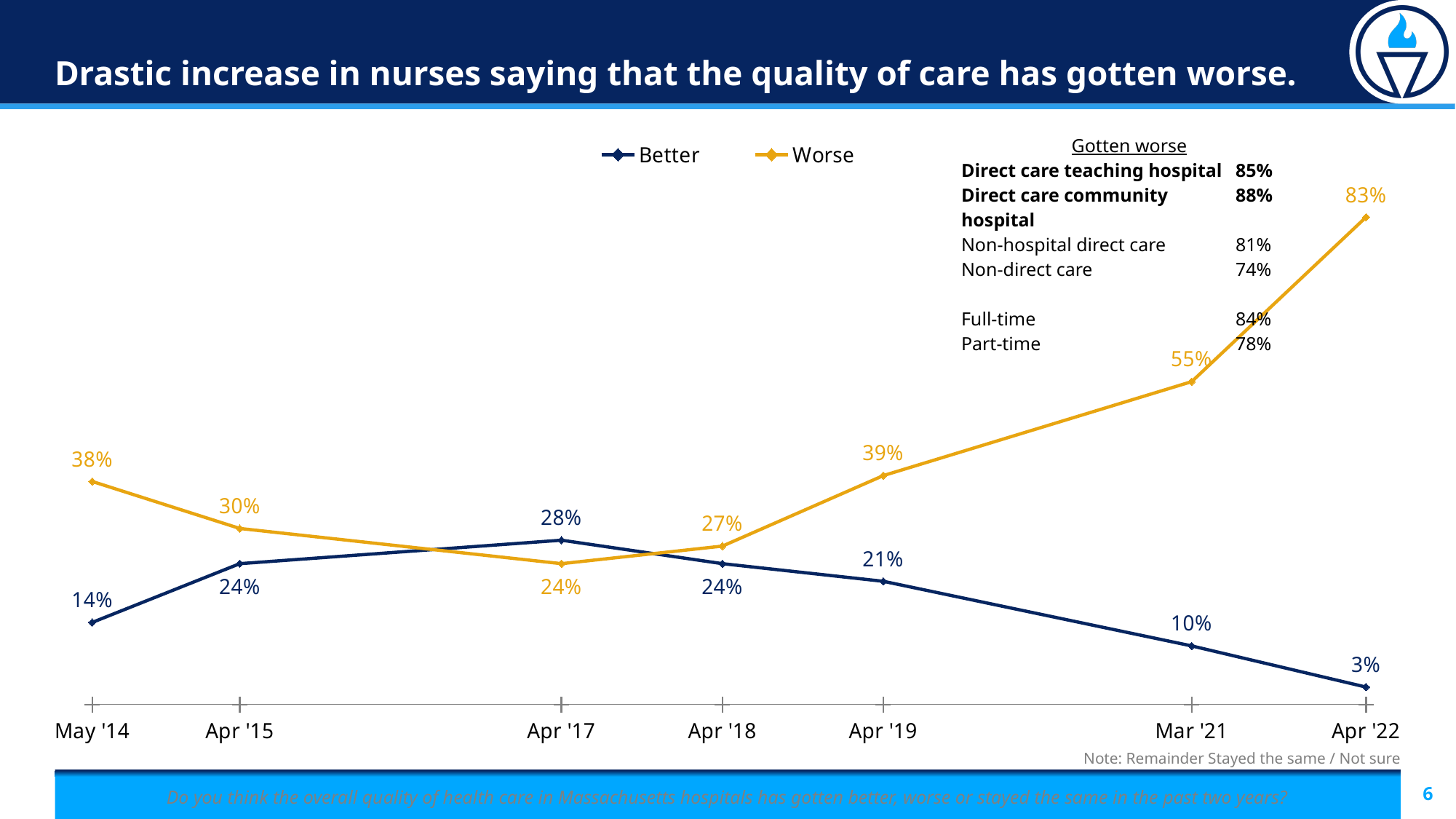
How many time points are shown on the x axis? 7 How many series does the legend list? 2 In which period is the Better series at its lowest? Apr '22 What is the value for Better in Apr '19? 21% What kind of chart is shown? Line chart In which period is the Worse series at its highest? Apr '22 Does the Better series rise or fall from Apr '17 to Apr '22? Fall What is the value for Worse in Apr '22? 83% Which is larger in Apr '17, Better or Worse? Better What is the value for Worse in Mar '21? 55% What is the value for Better in May '14? 14% What is the difference between Worse and Better in Apr '22? 80%